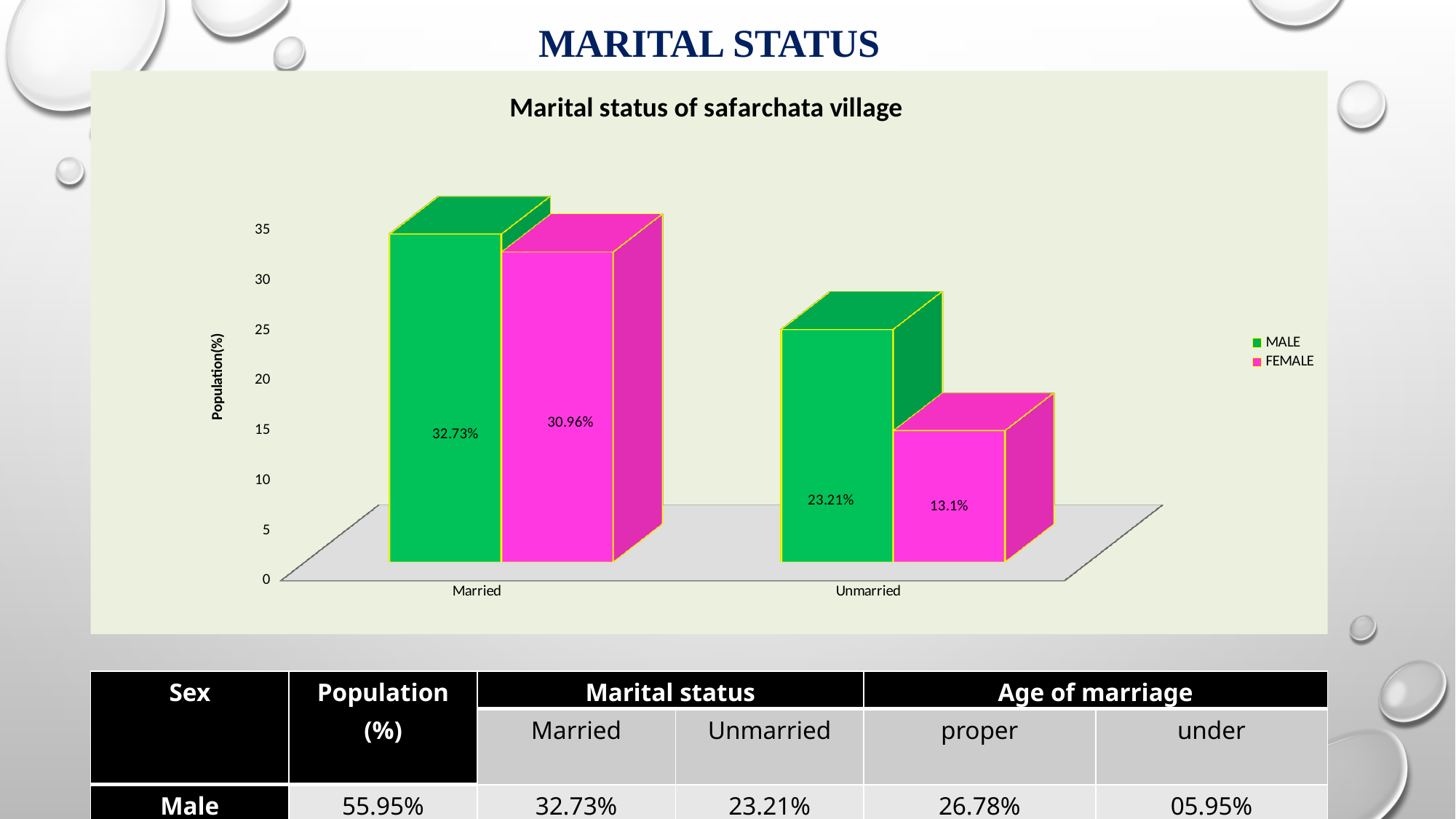
Which category has the highest MALE value? Married How many categories are shown on the x axis? 2 What is the FEMALE value for Unmarried? 13.1% Which is larger, the FEMALE value for Married or the FEMALE value for Unmarried? Married What is the FEMALE value for Married? 30.96% What is the MALE value for Married? 32.73% What kind of chart is shown? Bar chart What is the difference between the MALE values for Married and Unmarried? 9.52% How many series does the legend list? 2 What is the difference between the MALE and FEMALE values for Unmarried? 10.11% What is the MALE value for Unmarried? 23.21% Which category has the lowest FEMALE value? Unmarried